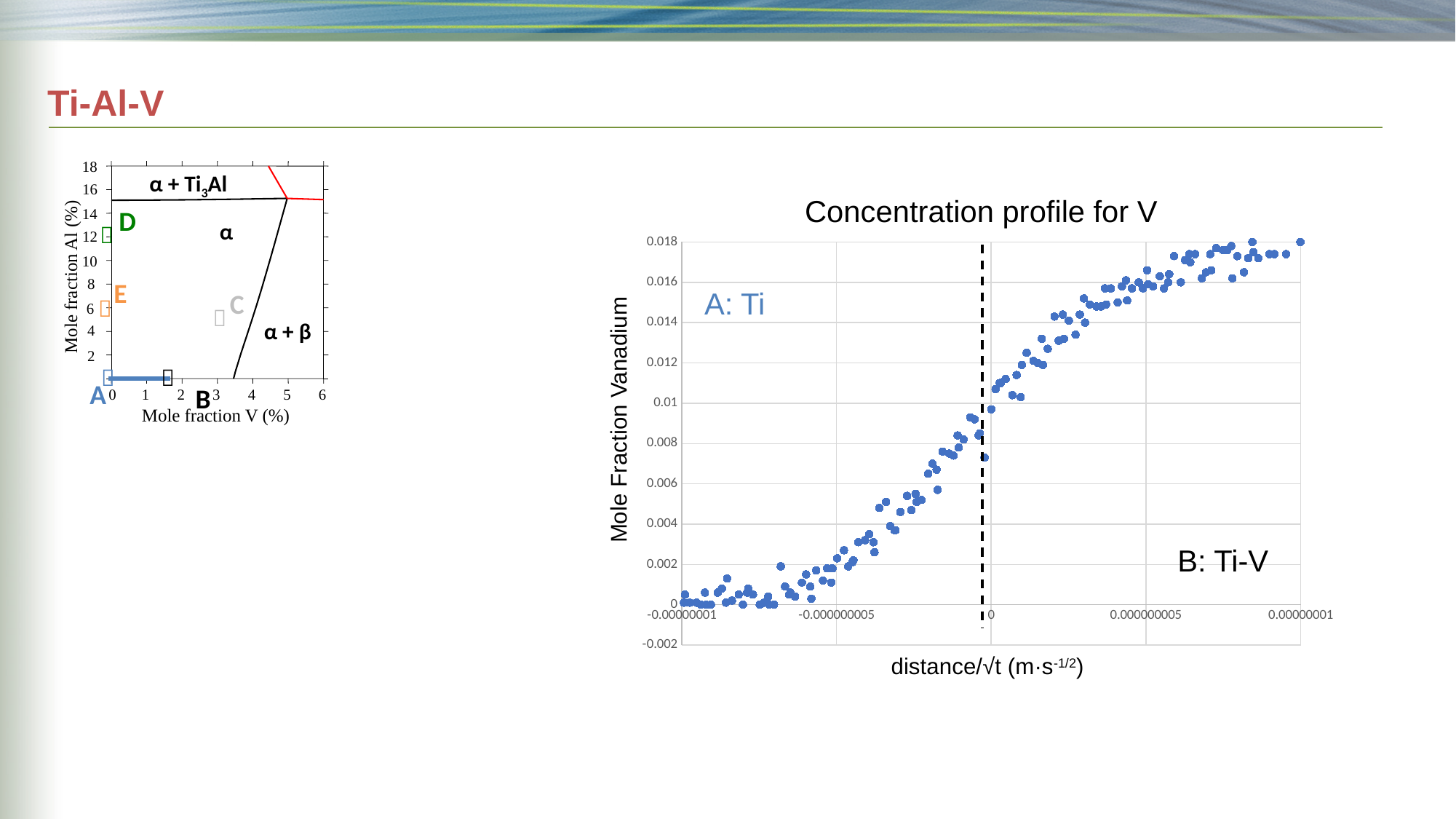
In the 'Concentration profile for V' chart, is the mole fraction of vanadium at distance/√t = -0.000000005 greater or less than 0.004? less In the 'Concentration profile for V' chart, is the mole fraction of vanadium at distance/√t = 0.00000001 greater or less than 0.016? greater What kind of chart is the 'Concentration profile for V' chart on the right of the slide? scatter chart What is the title of the scatter chart on the right of the slide? Concentration profile for V What is the y-axis title of the 'Concentration profile for V' chart? Mole Fraction Vanadium In the 'Concentration profile for V' chart, is the mole fraction of vanadium at the dashed line (distance/√t = 0) greater or less than 0.012? less In the 'Concentration profile for V' chart, do the values rise or fall as distance/√t increases along the x axis? rise In the 'Concentration profile for V' chart, which has the larger mole fraction of vanadium: the points at distance/√t = 0.000000005 or the points at distance/√t = -0.000000005? 0.000000005